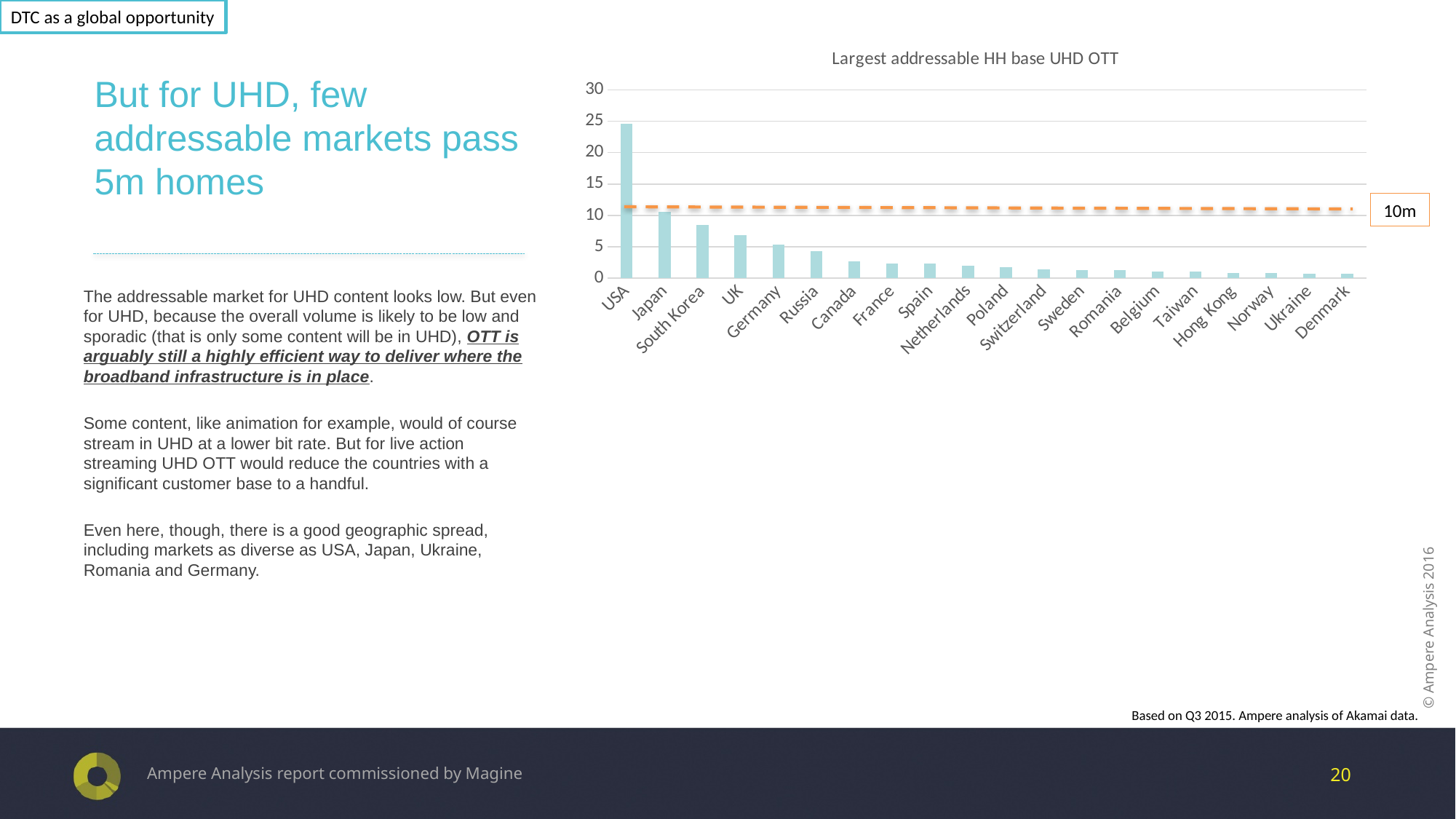
Is the value for UK greater or less than 5? greater What type of chart is shown on the slide? bar chart Which country has the highest value in the chart? USA Which has a larger value, South Korea or Germany? South Korea What is the title of the chart? Largest addressable HH base UHD OTT Is the value for USA greater or less than 20? greater Is the value for Denmark greater or less than 5? less Which has a larger value, USA or Japan? USA Do the values rise or fall moving from left to right along the x axis? fall How many countries are shown on the x axis of the chart? 20